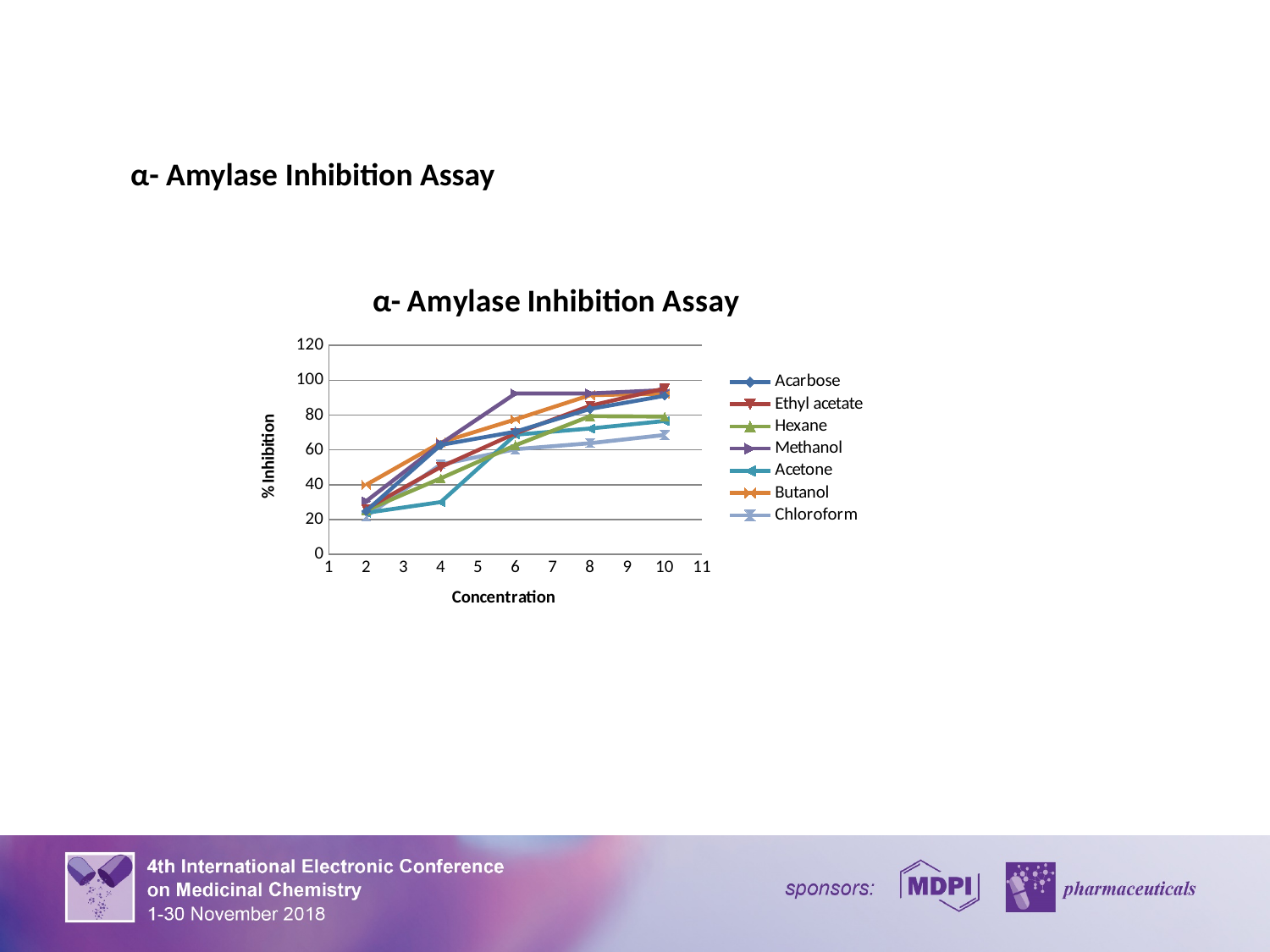
Which series has the highest value at concentration 6? Methanol What is the label on the y axis? % Inhibition How many series does the legend list? 7 What kind of chart is shown on the slide? line chart Is the value for Chloroform at concentration 10 greater or less than 80? less Is the value for Ethyl acetate at concentration 10 greater or less than 80? greater Is the value for Acetone at concentration 4 greater or less than 40? less Do the values for Methanol rise or fall as concentration increases? rise How many data points are plotted for the Methanol series? 5 Which series has the lowest value at concentration 4? Acetone At concentration 10, which is larger: Ethyl acetate or Chloroform? Ethyl acetate